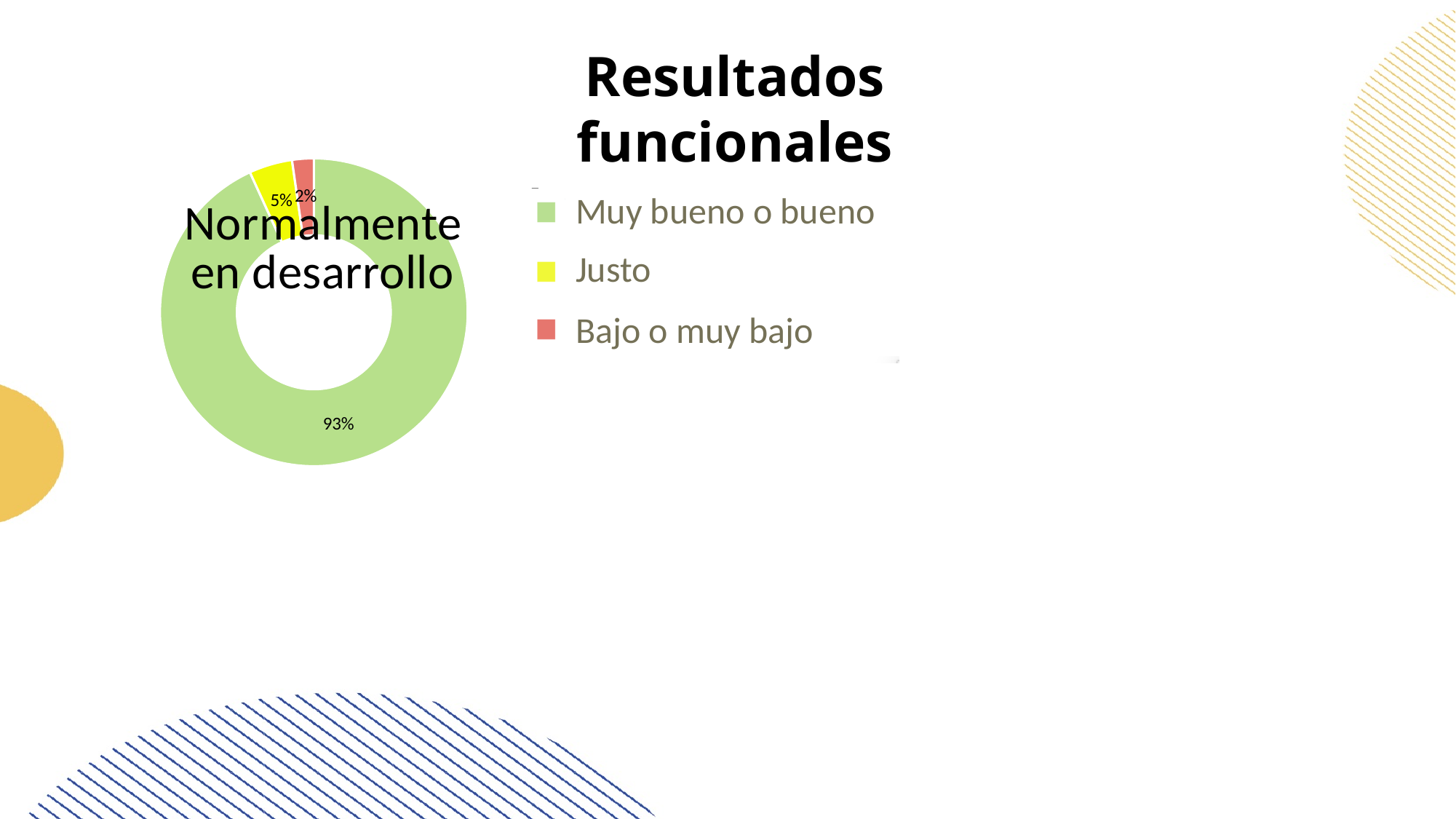
How many categories does the doughnut chart show? 3 What colour represents 'Justo' in the chart? Yellow Which is larger in the doughnut chart, 'Justo' or 'Bajo o muy bajo'? Justo Which category has the largest share in the doughnut chart? Muy bueno o bueno What percentage of the doughnut chart is 'Muy bueno o bueno'? 93% What percentage of the doughnut chart is 'Bajo o muy bajo'? 2% What text is written over the doughnut chart? Normalmente en desarrollo What percentage of the doughnut chart is 'Justo'? 5% Which category has the smallest share in the doughnut chart? Bajo o muy bajo What kind of chart is shown on the slide? Doughnut chart What is the difference in percentage points between 'Muy bueno o bueno' and 'Justo'? 88 What is the difference in percentage points between 'Justo' and 'Bajo o muy bajo'? 3